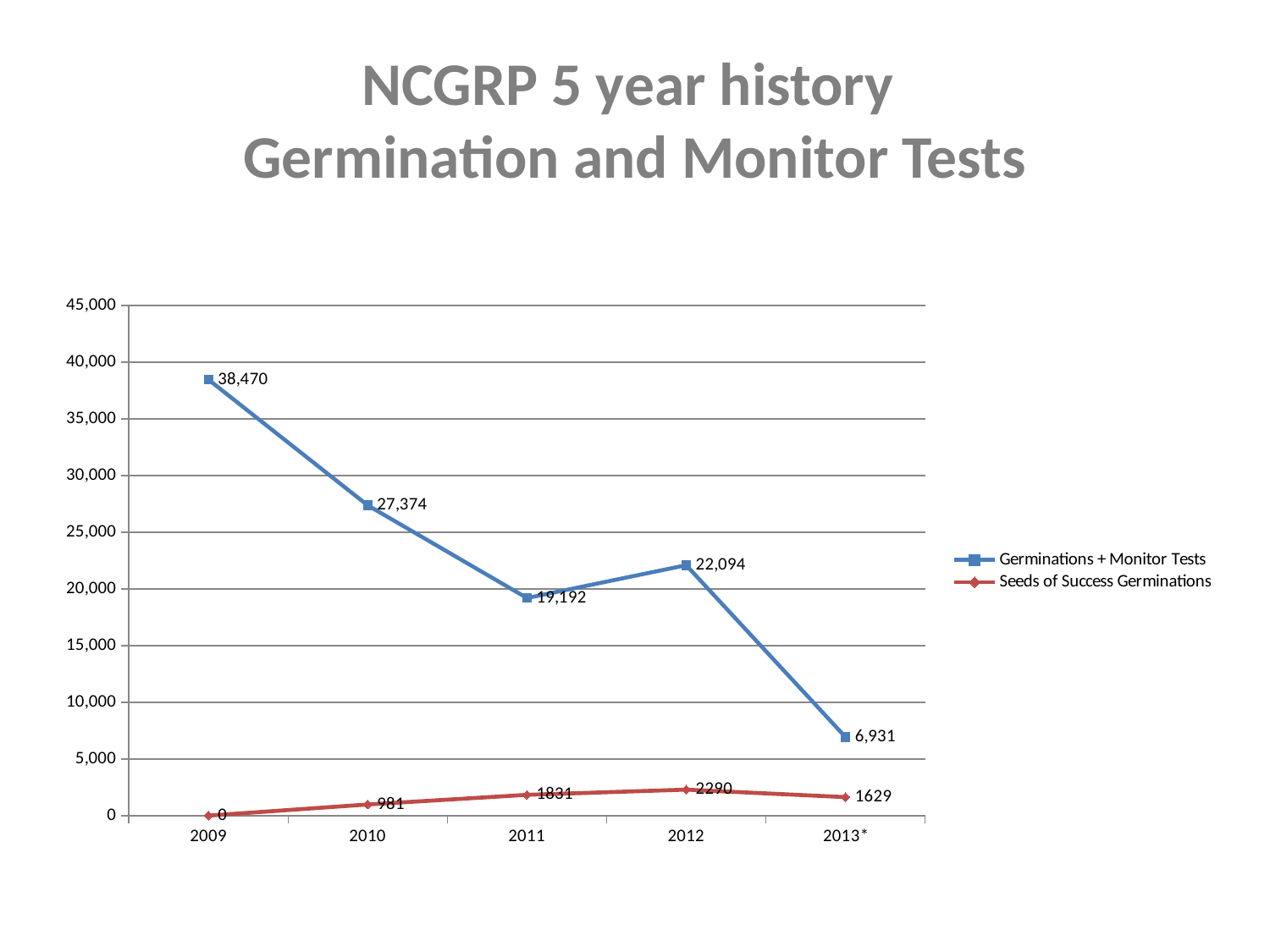
What is the value for Germinations + Monitor Tests in 2009? 38,470 Which is larger for Germinations + Monitor Tests: 2011 or 2012? 2012 What is the difference between Germinations + Monitor Tests in 2010 and in 2011? 8,182 In which year is Germinations + Monitor Tests highest? 2009 What is the value for Germinations + Monitor Tests in 2013*? 6,931 What kind of chart is shown? line chart Does Germinations + Monitor Tests rise or fall from 2009 to 2010? fall How many years are plotted on the x axis? 5 Is the value for Germinations + Monitor Tests in 2012 greater or less than 20,000? greater What is the value for Seeds of Success Germinations in 2012? 2290 How many series does the legend list? 2 In which year is Seeds of Success Germinations lowest? 2009